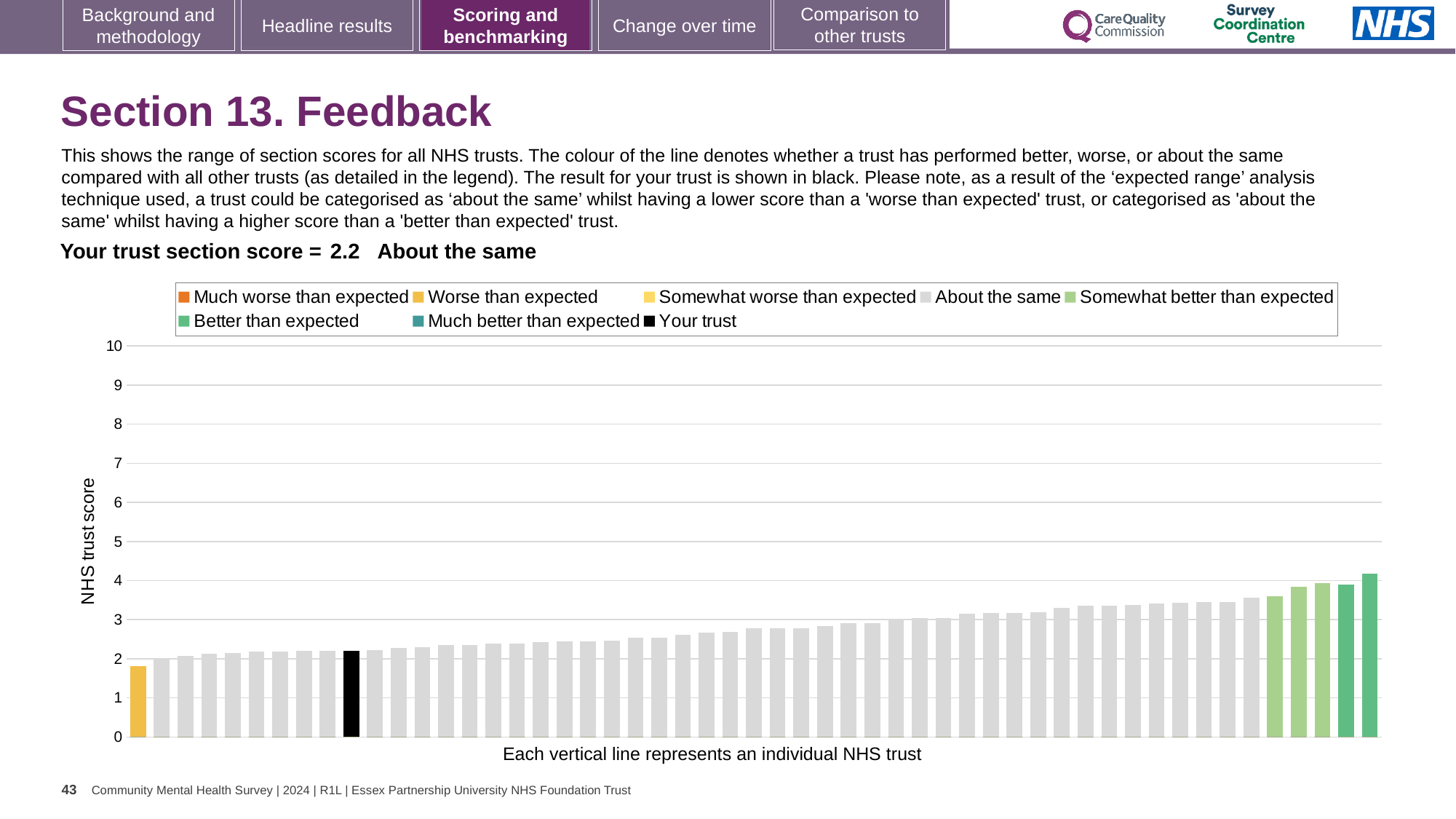
What kind of chart is shown on the slide? bar chart Is the value for your trust (the black bar) greater or less than 3? less Is the value of the tallest bar greater or less than 4? greater Which legend category does the tallest bar belong to? Better than expected Which legend category does the shortest bar belong to? Worse than expected Is the value of the leftmost (yellow) bar greater or less than 2? less Which is taller: the black bar for your trust or the yellow bar at the far left? the black bar (your trust) How many entries does the chart legend list? 8 Which category is your trust placed in for this section? About the same Do the bar values rise or fall from left to right along the x axis? rise What is the label on the y axis of the chart? NHS trust score What is the section score for your trust? 2.2